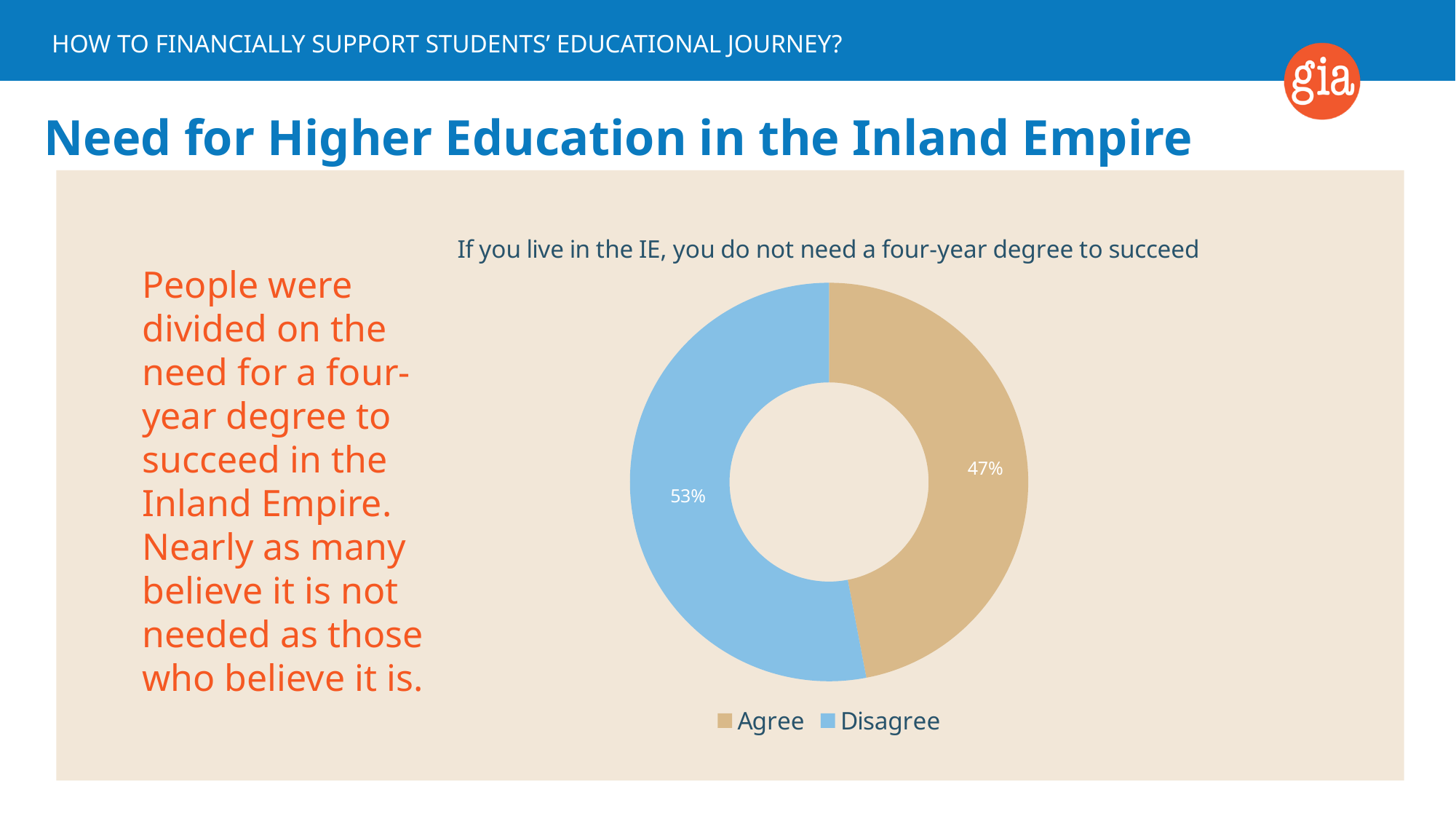
Which colour represents Disagree in the chart? Blue What percentage of respondents disagree with the statement in the chart? 53% Which response has the larger share in the chart, Agree or Disagree? Disagree How many categories does the chart show? 2 Which response has the smaller share in the chart? Agree What is the title of the chart? If you live in the IE, you do not need a four-year degree to succeed What kind of chart is shown on the slide? Doughnut (pie) chart What is the difference in percentage points between the Disagree and Agree shares? 6 percentage points Is the share for Agree larger or smaller than the share for Disagree? smaller What percentage of respondents agree that if you live in the IE, you do not need a four-year degree to succeed? 47% How many entries does the chart legend list? 2 What is the combined total of the Agree and Disagree shares? 100%